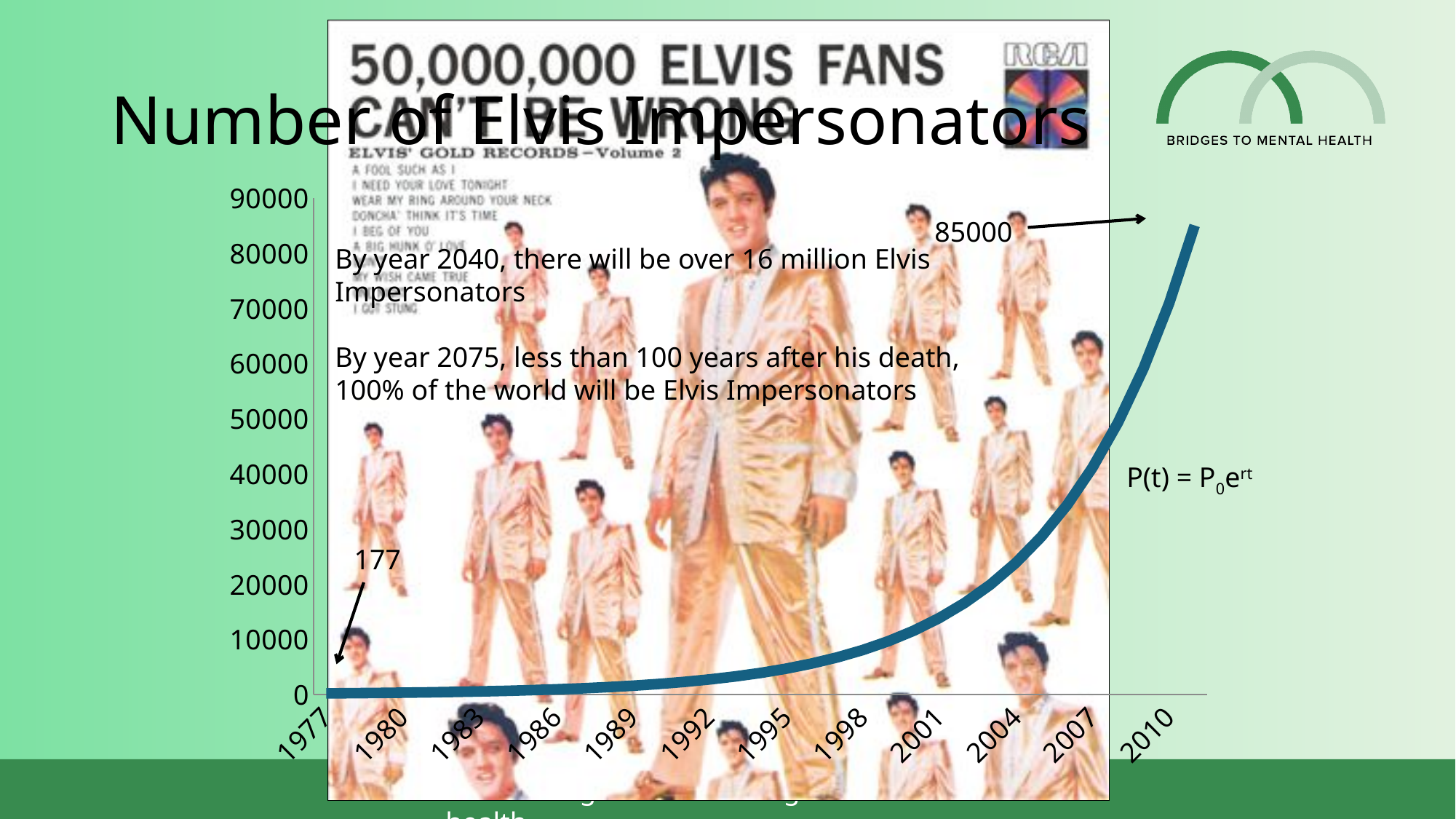
What kind of chart is shown on the slide? line chart Is the value for 1992 greater or less than 10000? less What is the difference between the labelled end value (85000) and the labelled start value (177)? 84823 What value is labelled at the end of the line near 2010? 85000 Which year on the x axis has the highest value on the line? 2010 How many year labels are shown on the x axis? 12 What is the title of the chart? Number of Elvis Impersonators Is the value for 1998 greater or less than 10000? less What value is labelled at the start of the line in 1977? 177 What is the highest value shown on the y axis? 90000 Is the value for 2007 greater or less than 30000? greater Do the values rise or fall as the years increase along the x axis? rise